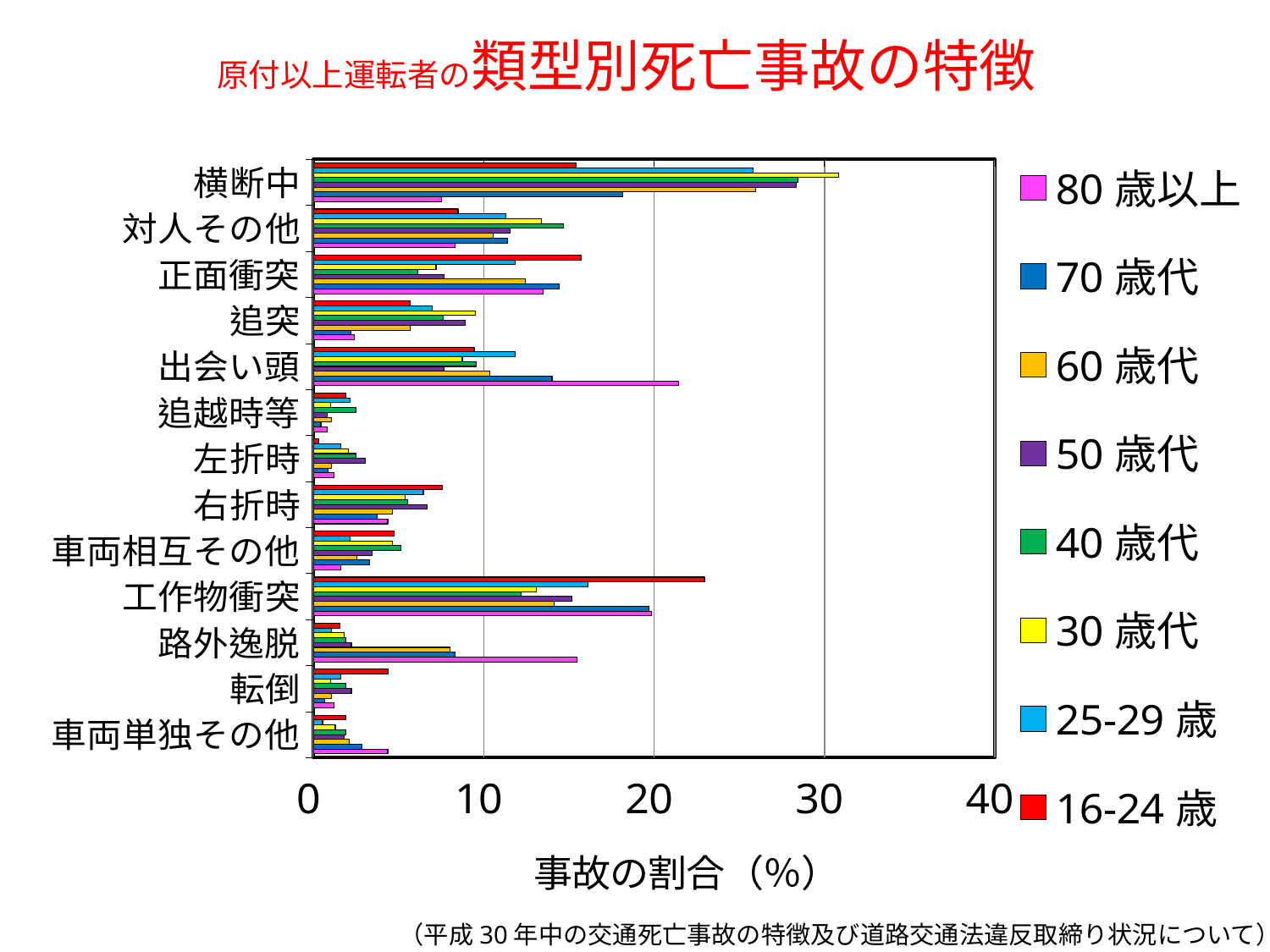
Which category has the highest value for the 30 歳代 series? 横断中 How many age-group series does the legend list? 8 Which category has the highest value for the 16-24 歳 series? 工作物衝突 What kind of chart is shown on the slide? bar chart Which age group is listed first (at the top) in the legend? 80 歳以上 In the 横断中 category, which is larger: the value for 70 歳代 or the value for 80 歳以上? 70 歳代 What is the title of the horizontal axis? 事故の割合（%） Is the value for 80 歳以上 in the 横断中 category greater or less than 10? less How many accident-type categories are listed on the vertical axis? 13 Is the value for 16-24 歳 in the 正面衝突 category greater or less than 10? greater Is the value for 80 歳以上 in the 路外逸脱 category greater or less than 10? greater